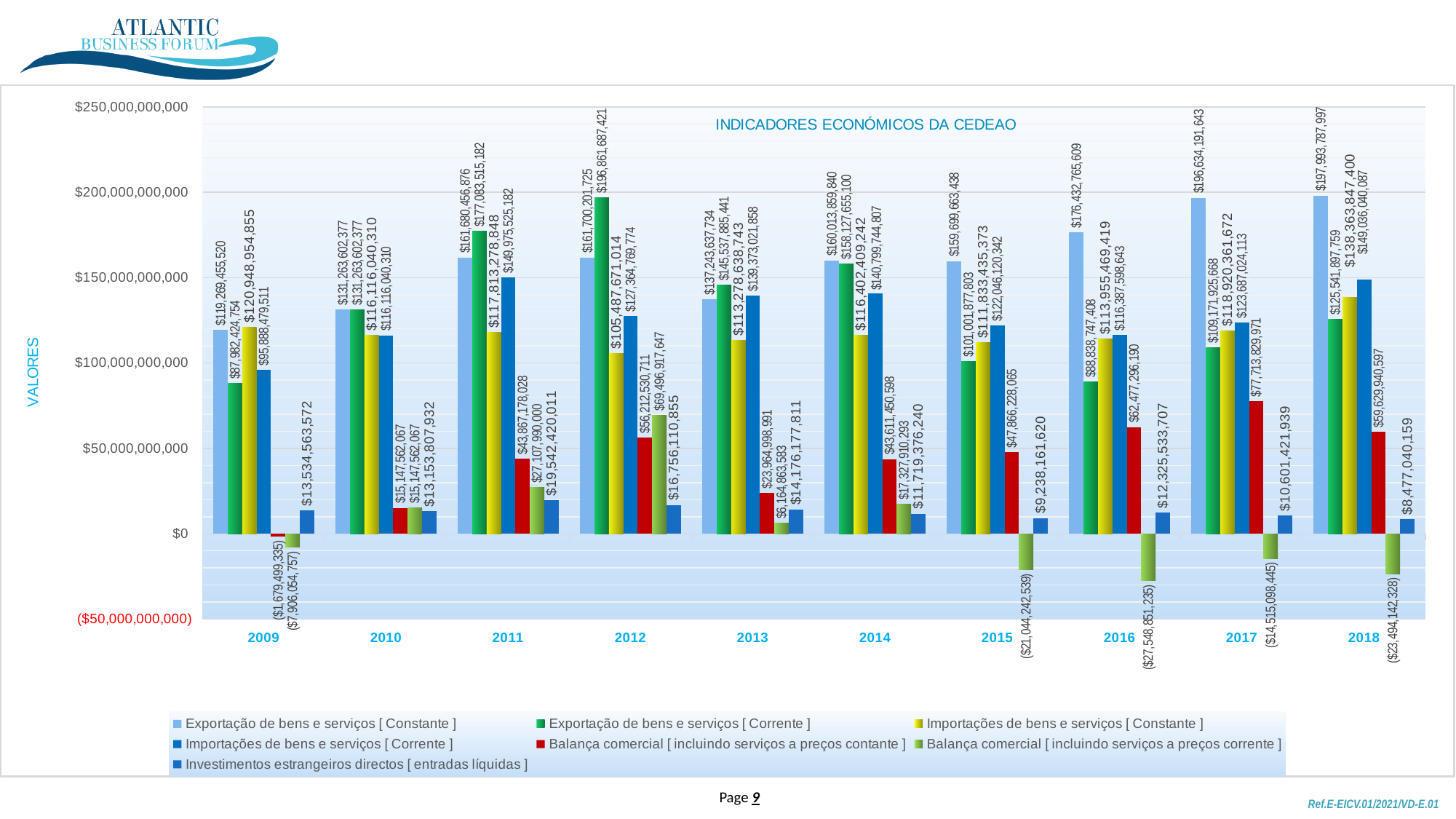
How many years are shown on the x axis? 10 What is the value of Balança comercial [ incluindo serviços a preços corrente ] in 2016? ($27,548,851,235) Does Exportação de bens e serviços [ Constante ] rise or fall from 2015 to 2018? rise In which year is Exportação de bens e serviços [ Corrente ] highest? 2012 In which year is Investimentos estrangeiros directos [ entradas líquidas ] lowest? 2018 What is the value of Investimentos estrangeiros directos [ entradas líquidas ] in 2011? $19,542,420,011 What is the difference between Exportação de bens e serviços [ Constante ] and Exportação de bens e serviços [ Corrente ] in 2017? $87,462,265,975 Which is larger in 2013: Importações de bens e serviços [ Corrente ] or Exportação de bens e serviços [ Constante ]? Importações de bens e serviços [ Corrente ] What type of chart is shown on the slide? bar chart What is the title of the chart? INDICADORES ECONÓMICOS DA CEDEAO What is the value of Exportação de bens e serviços [ Constante ] in 2018? $197,993,787,997 How many series does the legend list? 7